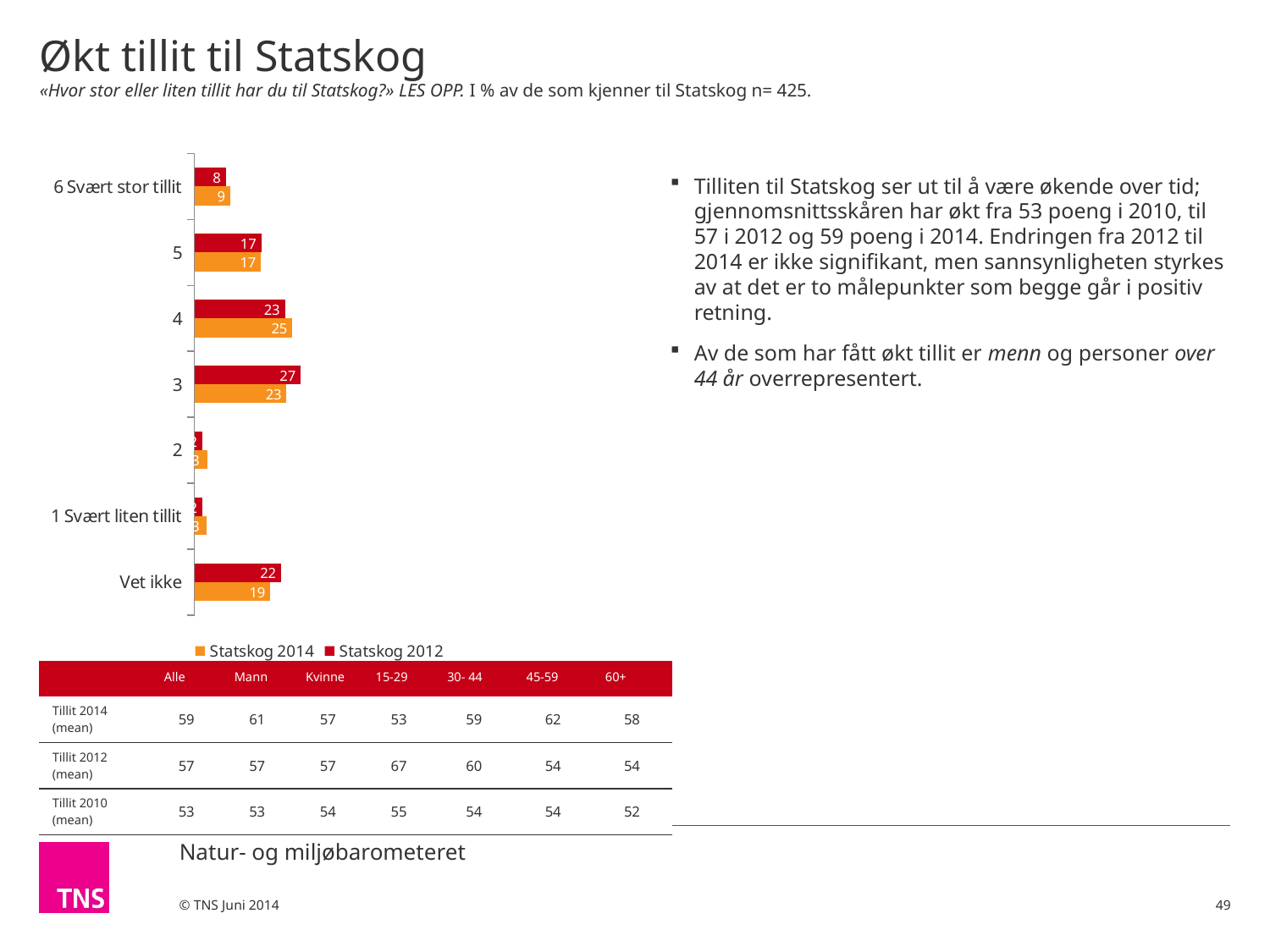
How many series does the chart legend list? 2 What is the value for Statskog 2014 in the category '6 Svært stor tillit'? 9 What is the value for Statskog 2014 in the category 'Vet ikke'? 19 What is the difference between the Statskog 2012 and Statskog 2014 values in the category '3'? 4 Which category has the highest value for Statskog 2012? 3 Which colour represents the Statskog 2014 series in the chart? orange What is the value for Statskog 2012 in the category '4'? 23 How many categories are shown on the chart's vertical axis? 7 In the category 'Vet ikke', which series has the larger value, Statskog 2014 or Statskog 2012? Statskog 2012 What type of chart is shown on the slide? bar chart Which category has the highest value for Statskog 2014? 4 What is the value for Statskog 2012 in the category '3'? 27